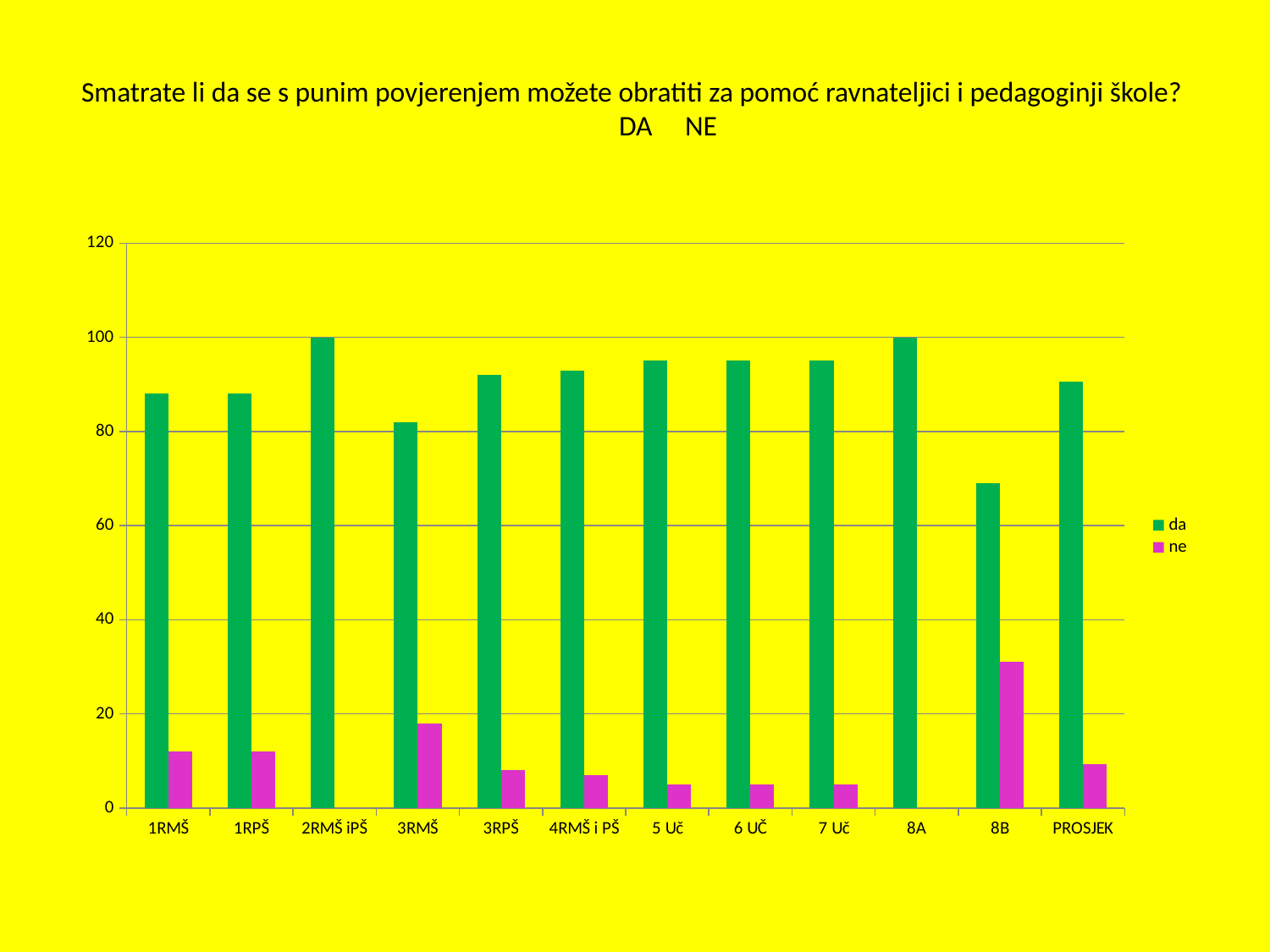
How many categories are shown along the x axis? 12 What is the value of the "da" bar for 8A? 100 Which colour represents the "da" series in the legend? green Is the "ne" value for 8B greater or less than 20? greater Is the "da" value for PROSJEK greater or less than 80? greater Which category has the highest "ne" value? 8B How many series does the legend list? 2 Which category has the lowest "da" value? 8B What is the value of the "da" bar for 2RMŠ iPŠ? 100 Is the "da" value for 8B greater or less than 80? less Which is larger, the "ne" value for 3RMŠ or the "ne" value for 5 Uč? 3RMŠ What kind of chart is shown on the slide? bar chart